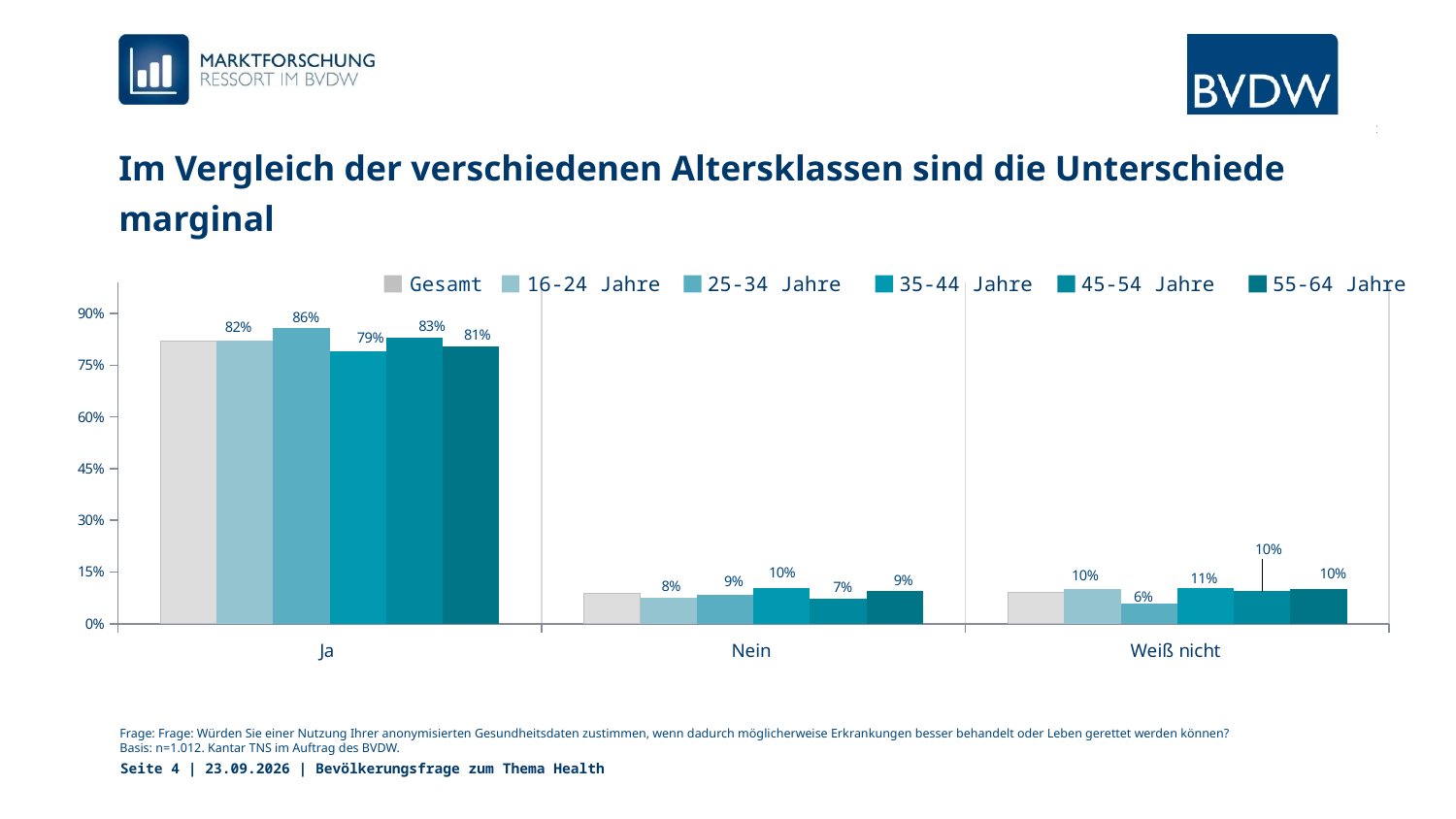
What is the value for 35-44 Jahre in the Weiß nicht category? 11% Which age group has the highest value in the Ja category? 25-34 Jahre What kind of chart is shown on the slide? bar chart Which age group has the lowest value in the Ja category? 35-44 Jahre What is the value for 25-34 Jahre in the Ja category? 86% In the Nein category, which is larger: the value for 35-44 Jahre or 45-54 Jahre? 35-44 Jahre What is the value for 25-34 Jahre in the Weiß nicht category? 6% How many series does the legend list? 6 What is the value for 45-54 Jahre in the Nein category? 7% Is the Gesamt value for Ja greater or less than 75%? greater What is the difference between the Ja values for 25-34 Jahre and 35-44 Jahre? 7 percentage points Which age group has the lowest value in the Weiß nicht category? 25-34 Jahre